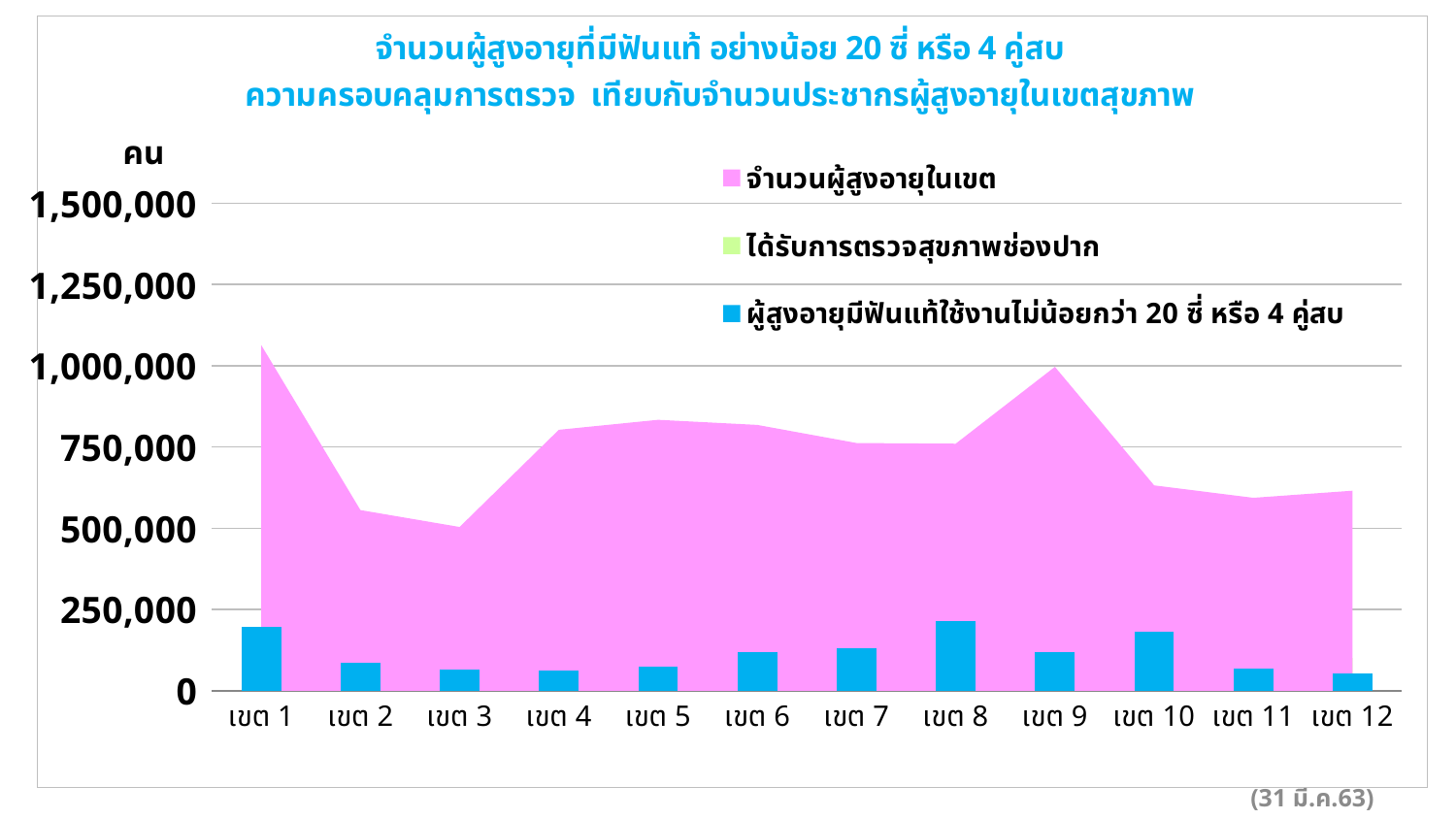
How many series does the legend list? 3 What unit label is shown at the top of the y axis? คน Is the value of ผู้สูงอายุมีฟันแท้ใช้งานไม่น้อยกว่า 20 ซี่ หรือ 4 คู่สบ for เขต 8 greater or less than 250,000? less Is the value of จำนวนผู้สูงอายุในเขต for เขต 5 greater or less than 750,000? greater Which region has the highest value for ผู้สูงอายุมีฟันแท้ใช้งานไม่น้อยกว่า 20 ซี่ หรือ 4 คู่สบ (blue bars)? เขต 8 What kind of chart is this? Combination area and bar chart Is the value of จำนวนผู้สูงอายุในเขต for เขต 12 greater or less than 500,000? greater Which has the larger value for ผู้สูงอายุมีฟันแท้ใช้งานไม่น้อยกว่า 20 ซี่ หรือ 4 คู่สบ, เขต 8 or เขต 2? เขต 8 Which region has the highest value for จำนวนผู้สูงอายุในเขต (pink area)? เขต 1 How many health regions (เขต) are shown on the x axis? 12 Which region has the lowest value for จำนวนผู้สูงอายุในเขต (pink area)? เขต 3